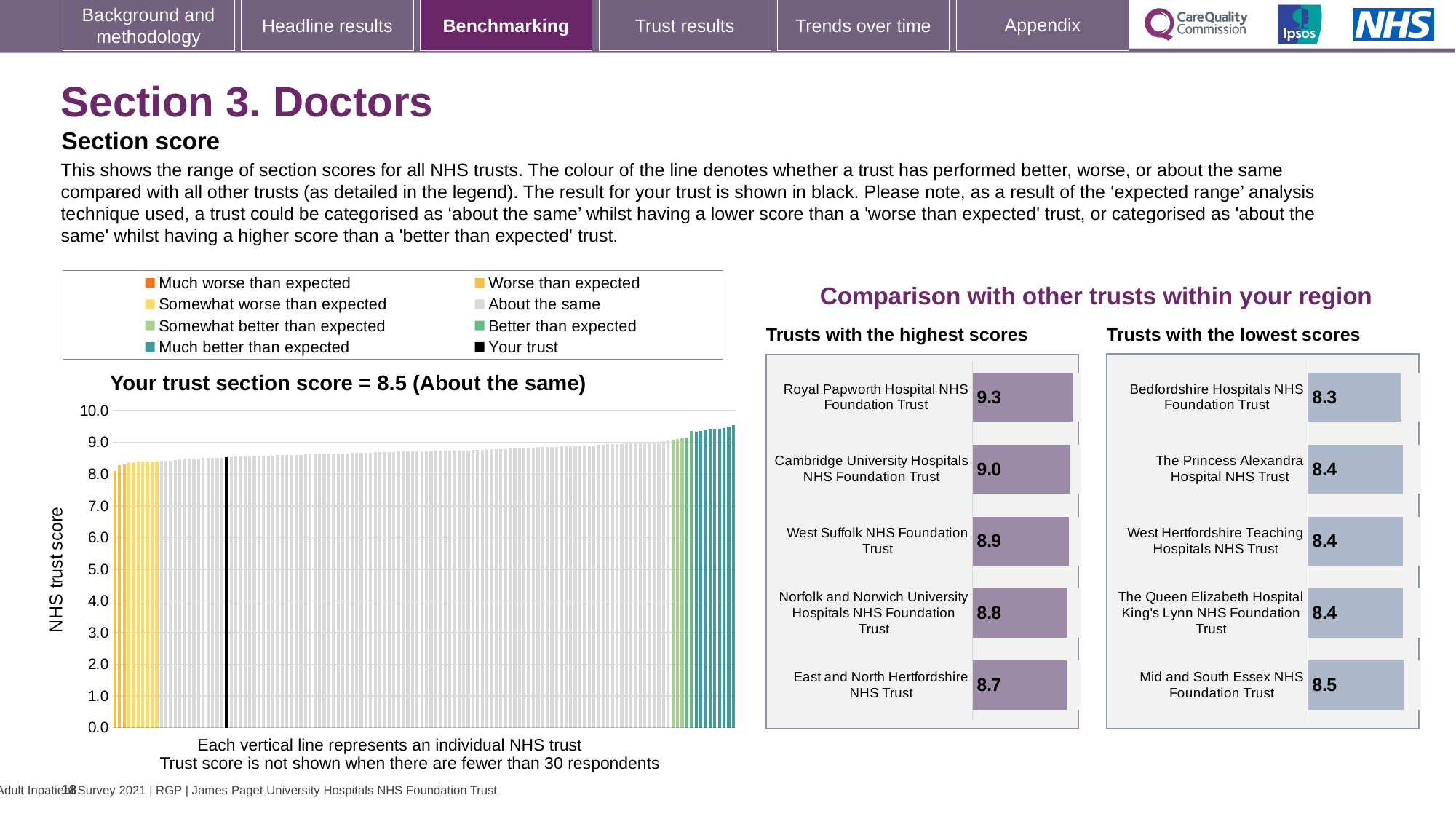
What type of chart is the 'Your trust section score' chart on the left? Bar chart In the 'Trusts with the highest scores' chart, which has the higher score: Cambridge University Hospitals NHS Foundation Trust or West Suffolk NHS Foundation Trust? Cambridge University Hospitals NHS Foundation Trust How many entries does the legend above the left-hand chart list? 8 In the 'Trusts with the highest scores' chart, which trust has the lowest score shown? East and North Hertfordshire NHS Trust How many trusts are listed in the 'Trusts with the lowest scores' chart? 5 In the 'Trusts with the lowest scores' chart, which trust has the highest score shown? Mid and South Essex NHS Foundation Trust In the 'Trusts with the highest scores' chart, what is the score for Royal Papworth Hospital NHS Foundation Trust? 9.3 According to the title of the left-hand chart, what is your trust's section score? 8.5 (About the same) What is the label on the vertical axis of the left-hand chart? NHS trust score In the 'Trusts with the highest scores' chart, what is the difference between the scores of Royal Papworth Hospital NHS Foundation Trust and East and North Hertfordshire NHS Trust? 0.6 In the 'Trusts with the lowest scores' chart, what is the score for Mid and South Essex NHS Foundation Trust? 8.5 In the 'Trusts with the lowest scores' chart, what is the score for Bedfordshire Hospitals NHS Foundation Trust? 8.3